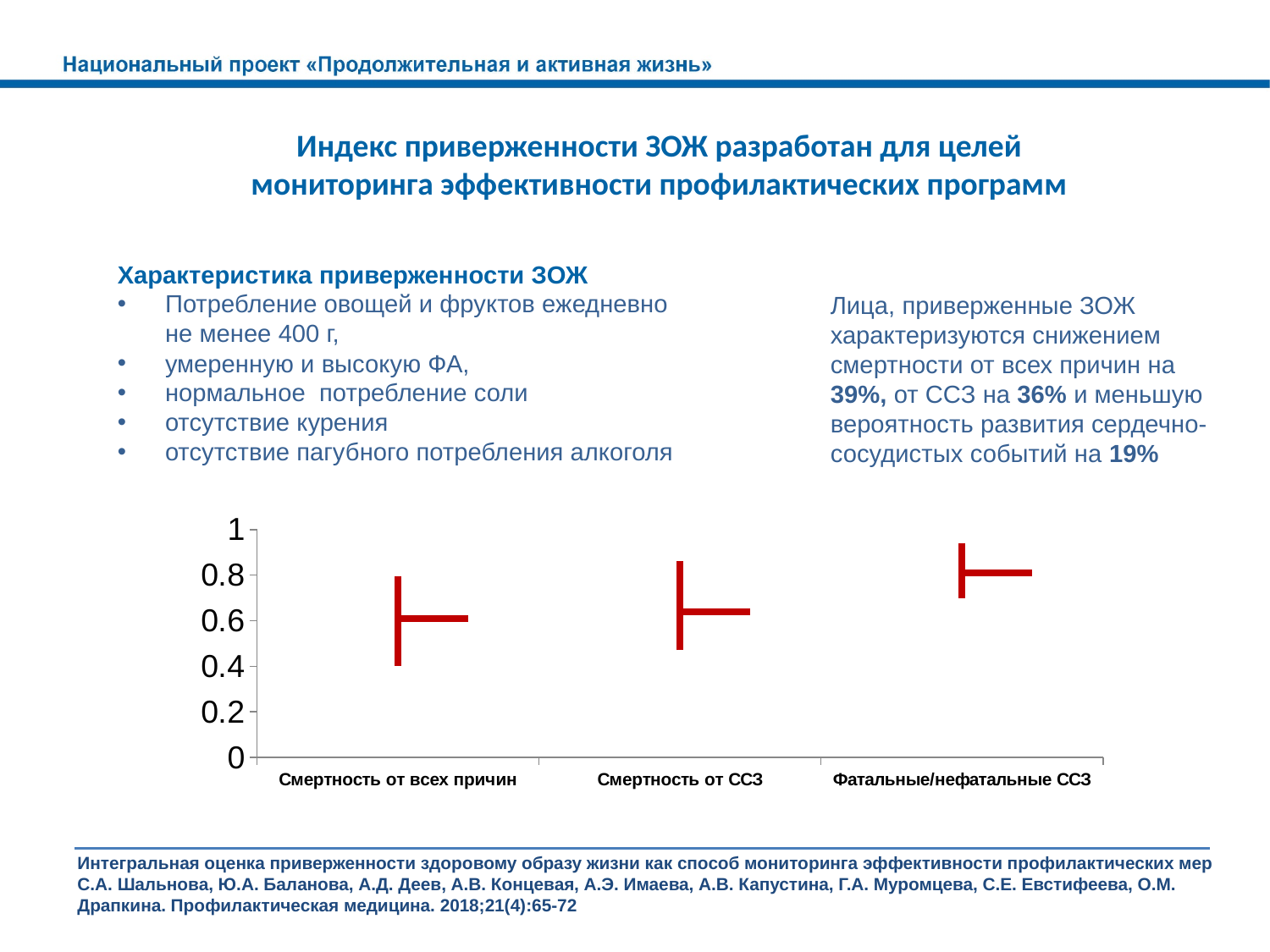
What is the highest tick value shown on the y axis of the chart? 1 Which is larger: the plotted value for Фатальные/нефатальные ССЗ or for Смертность от всех причин? Фатальные/нефатальные ССЗ Is the plotted value for Фатальные/нефатальные ССЗ greater or less than 0.6? greater Is the plotted value for Смертность от всех причин greater or less than 0.8? less What colour are the markers and error bars in the chart? red Is the plotted value for Смертность от ССЗ greater or less than 0.8? less Which category has the highest plotted value in the chart? Фатальные/нефатальные ССЗ What is the label of the middle category on the x axis? Смертность от ССЗ Do the plotted values rise or fall from left to right along the x axis? rise How many categories are shown on the x axis of the chart? 3